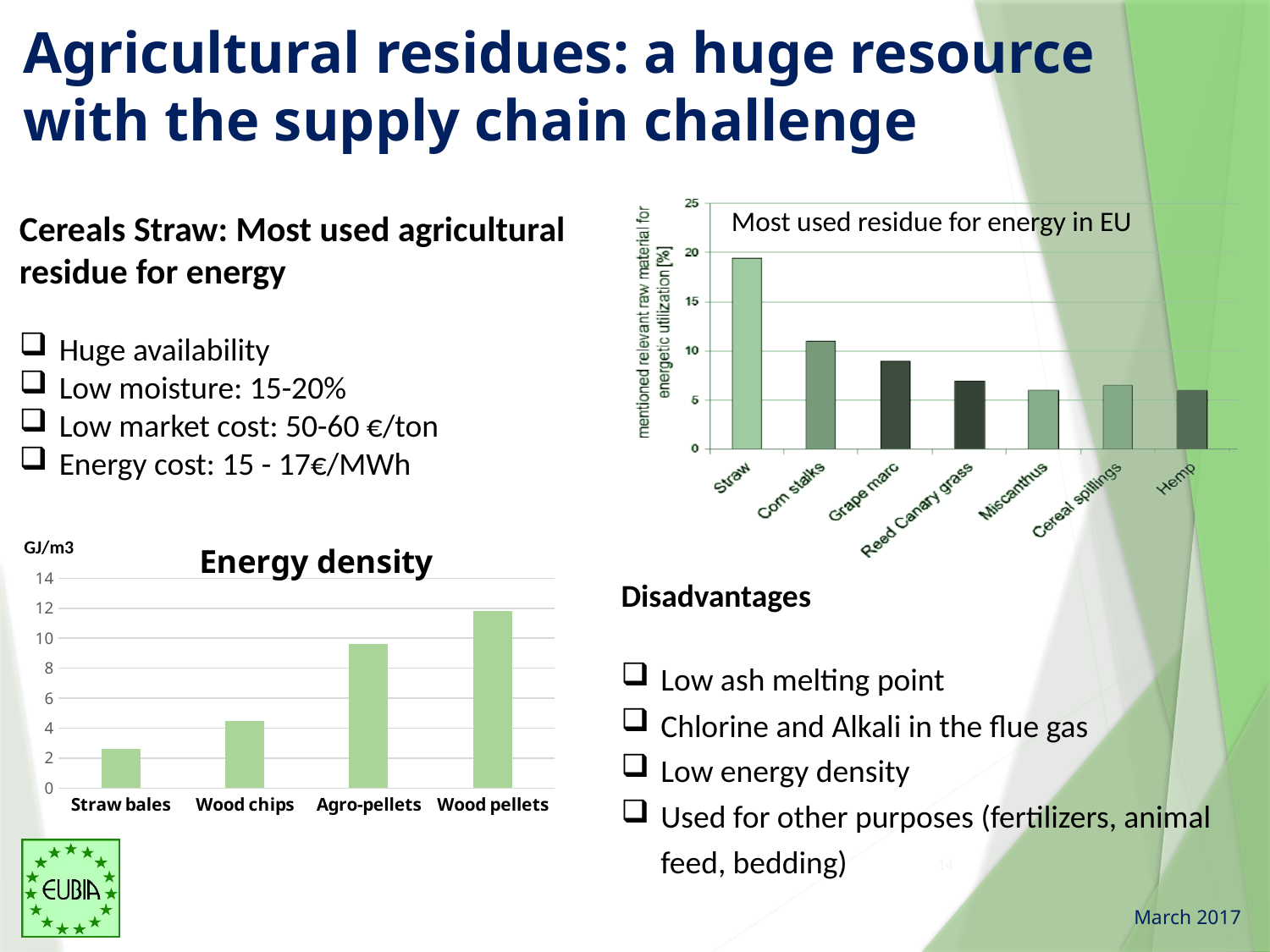
In the Energy density chart, is the value for Wood chips greater or less than 6? less In the Most used residue for energy in EU chart, is the value for Straw greater or less than 15? greater In the Energy density chart, is the value for Agro-pellets greater or less than 8? greater In the Energy density chart, which is larger, Wood chips or Agro-pellets? Agro-pellets In the Energy density chart, which category has the highest value? Wood pellets How many residues are shown in the Most used residue for energy in EU chart? 7 What unit is shown on the y axis of the Energy density chart? GJ/m3 How many categories are shown in the Energy density chart? 4 In the Most used residue for energy in EU chart, which is larger, Corn stalks or Grape marc? Corn stalks In the Most used residue for energy in EU chart, which residue has the highest value? Straw In the Energy density chart, which category has the lowest value? Straw bales